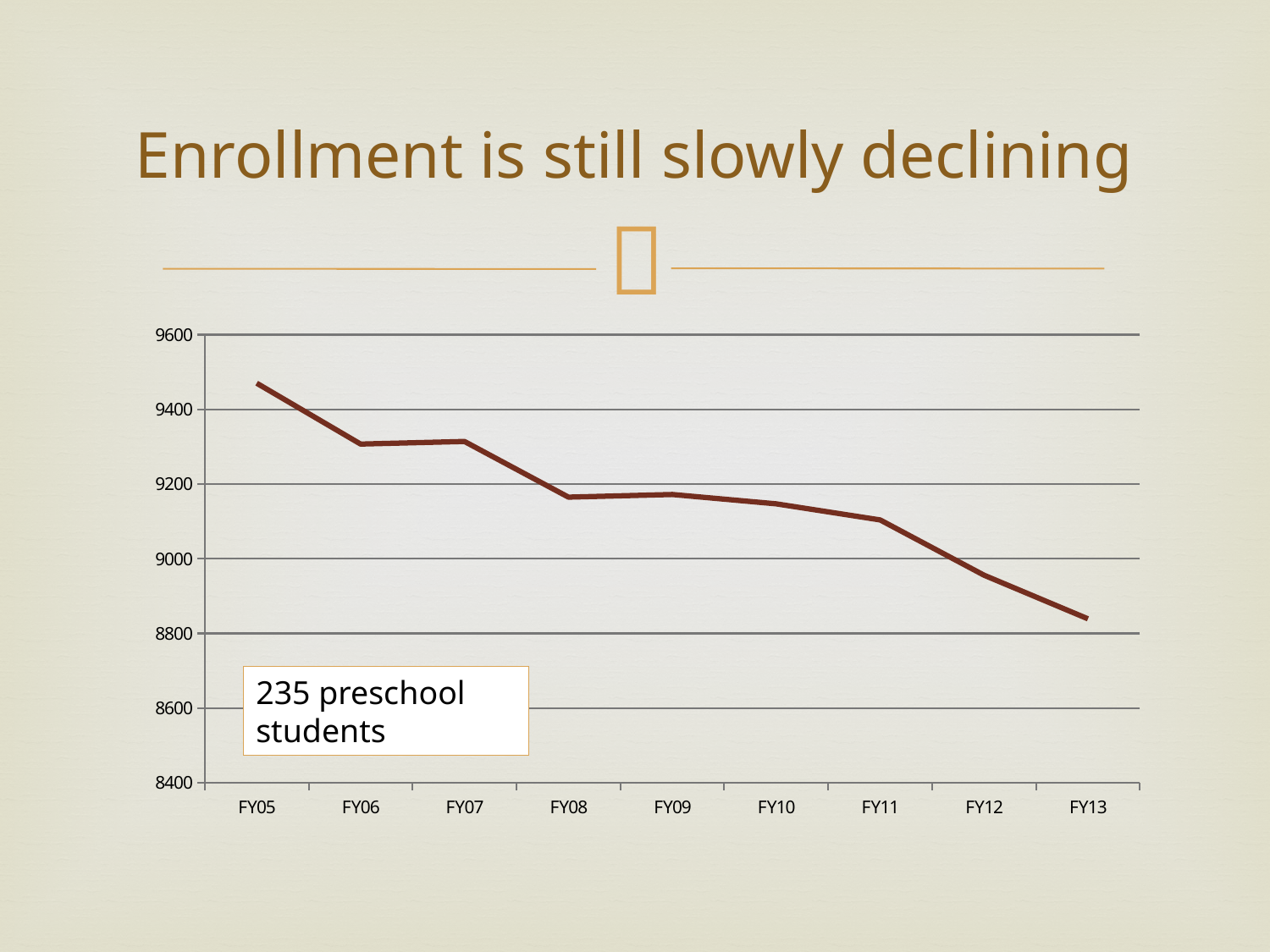
Is the enrollment for FY12 greater or less than 9000? less What is the title of the slide? Enrollment is still slowly declining Which fiscal year has the lowest enrollment? FY13 Does enrollment rise or fall from FY05 to FY13? fall Is the enrollment for FY05 greater or less than 9400? greater What does the text box on the chart say? 235 preschool students Which fiscal year has the highest enrollment? FY05 Is the enrollment for FY11 greater or less than 9000? greater Which is larger, the enrollment for FY11 or for FY12? FY11 How many fiscal years are plotted on the x axis? 9 What kind of chart is shown on the slide? line chart